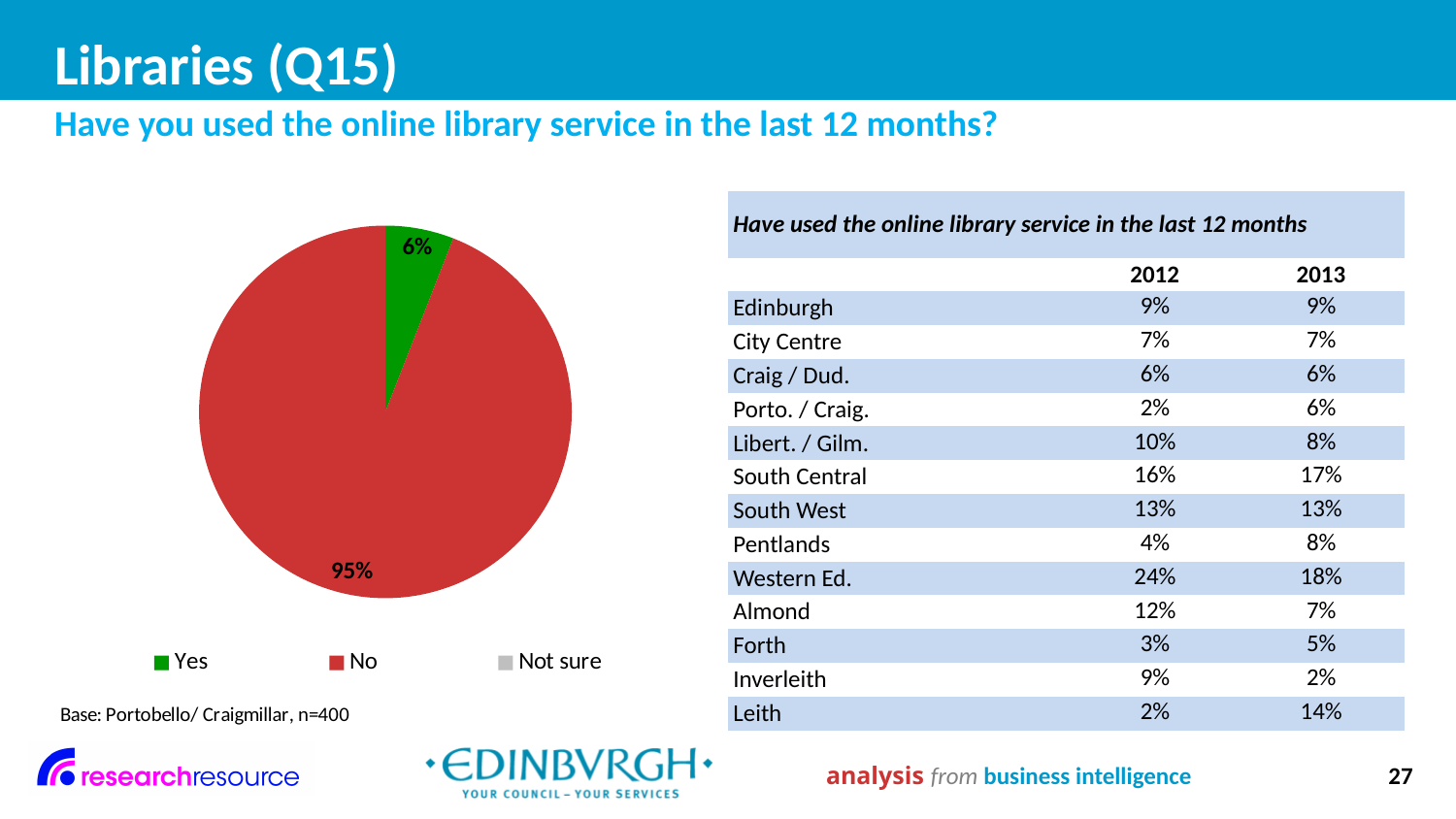
What base is stated beneath the pie chart? Portobello/ Craigmillar, n=400 How many entries does the pie chart's legend list? 3 How many slices in the pie chart have a percentage label printed on them? 2 What colour is the 'Yes' slice in the pie chart? Green What percentage of respondents answered 'No' in the pie chart? 95% What kind of chart is shown on the slide? Pie chart Which is larger in the pie chart, the 'Yes' slice or the 'No' slice? No What is the difference in percentage points between the 'No' and 'Yes' slices of the pie chart? 89 percentage points Which response has the largest slice in the pie chart? No Of the two labelled slices in the pie chart, which is smaller? Yes What share of the pie chart does the 'No' slice represent? 95% What percentage of respondents answered 'Yes' in the pie chart? 6%